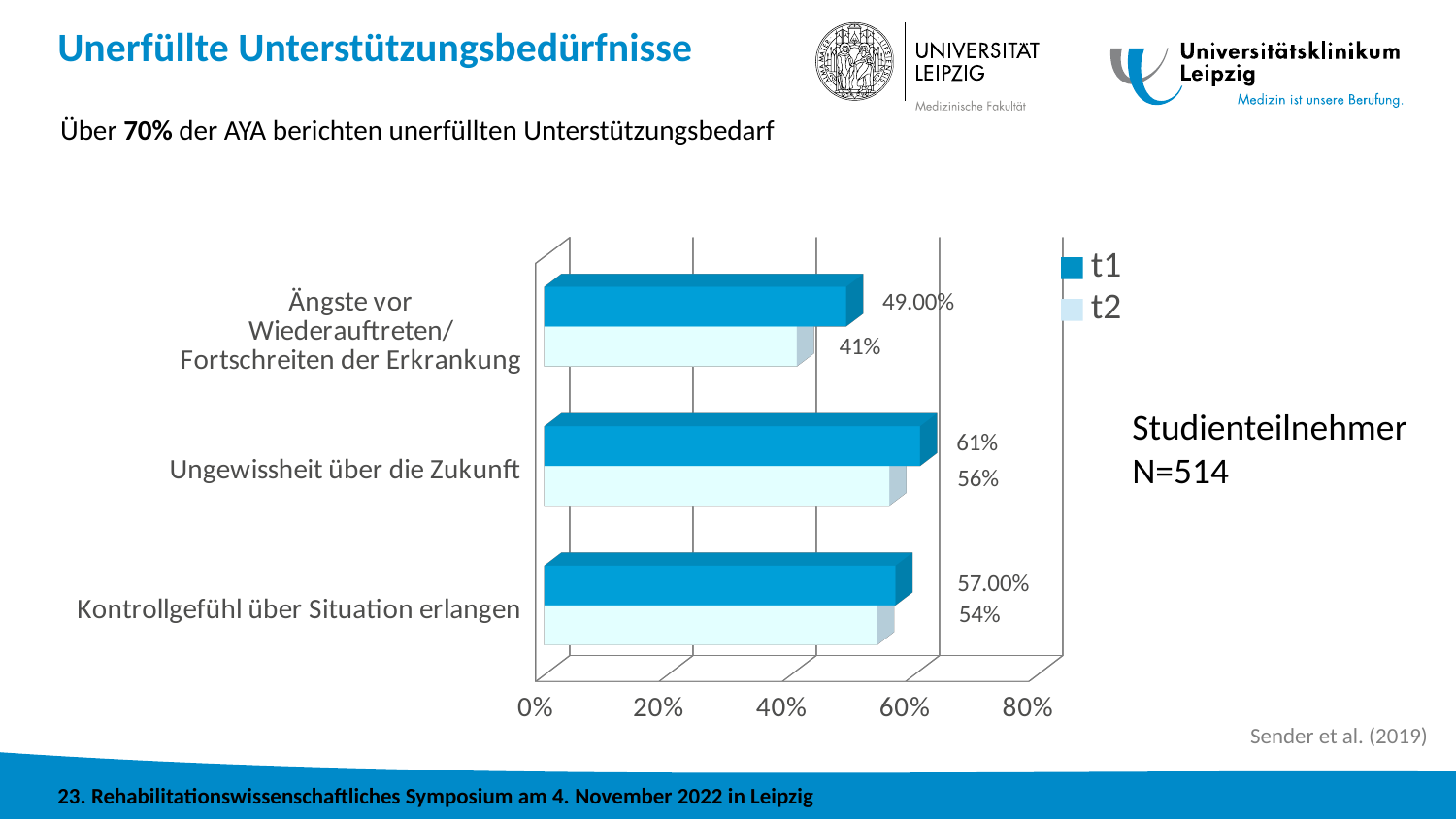
What is the t1 value for "Kontrollgefühl über Situation erlangen"? 57.00% Which is larger: the t1 value for "Ungewissheit über die Zukunft" or the t1 value for "Kontrollgefühl über Situation erlangen"? Ungewissheit über die Zukunft What is the t1 value for "Ungewissheit über die Zukunft"? 61% How many categories are shown in the chart? 3 What is the t2 value for "Kontrollgefühl über Situation erlangen"? 54% How many series does the legend list? 2 What is the difference between the t1 and t2 values for "Ungewissheit über die Zukunft"? 5 percentage points Which category has the lowest t2 value? Ängste vor Wiederauftreten/Fortschreiten der Erkrankung What is the difference between the t1 and t2 values for "Ängste vor Wiederauftreten/Fortschreiten der Erkrankung"? 8 percentage points What kind of chart is shown on the slide? Bar chart What is the t2 value for "Ängste vor Wiederauftreten/Fortschreiten der Erkrankung"? 41% Which category has the highest t1 value? Ungewissheit über die Zukunft